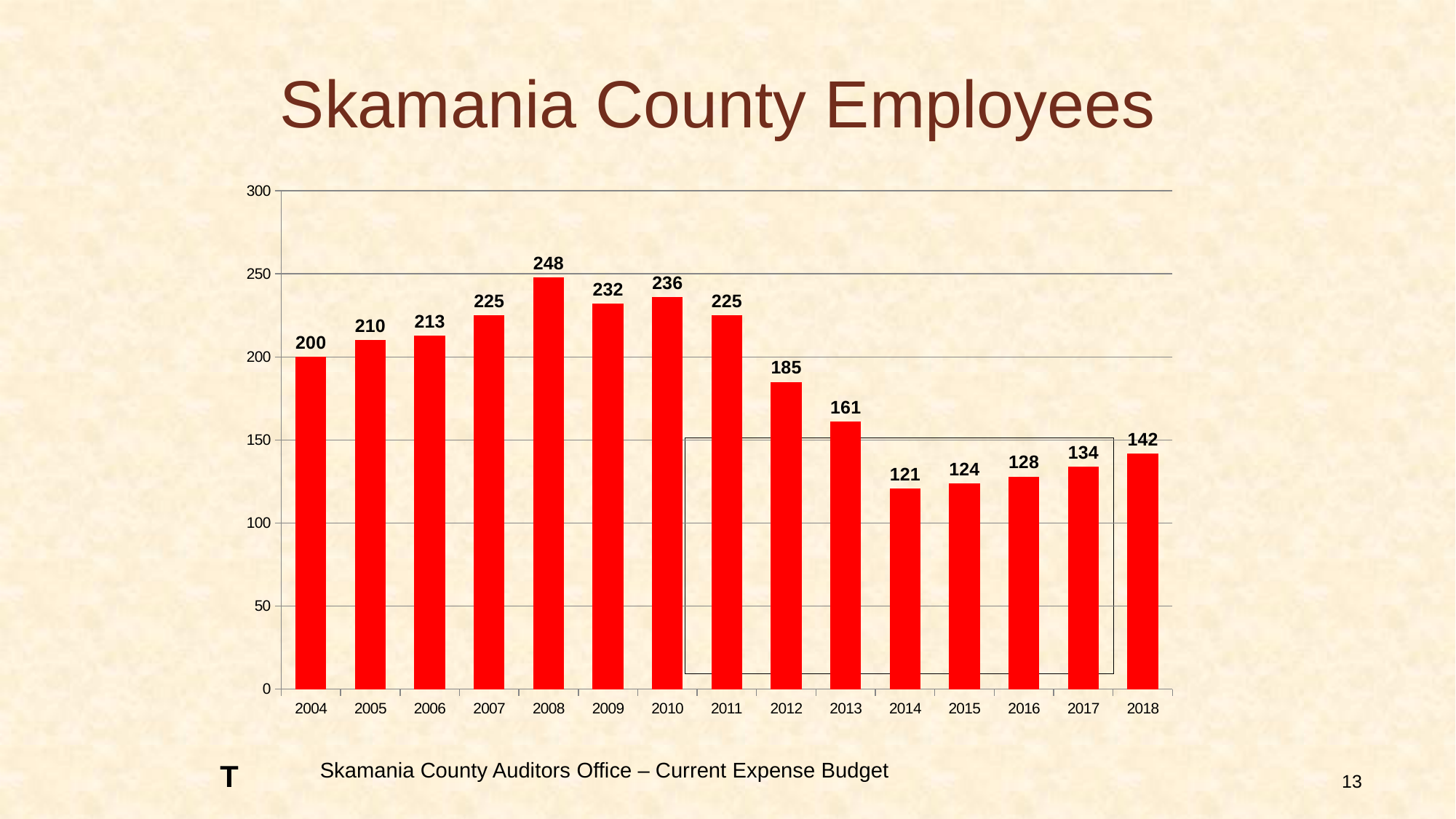
What is the number of Skamania County employees shown for 2008? 248 What value is shown for 2018? 142 What is the title of the chart? Skamania County Employees What kind of chart is shown on the slide? Bar chart Which is larger, the value for 2010 or the value for 2011? 2010 What is the difference between the values for 2008 and 2014? 127 How many years are shown on the x axis? 15 What value is shown for 2014? 121 Which year has the lowest number of employees? 2014 Which year has the highest number of employees? 2008 What is the difference between the values for 2012 and 2013? 24 Is the value for 2013 greater or less than 150? greater